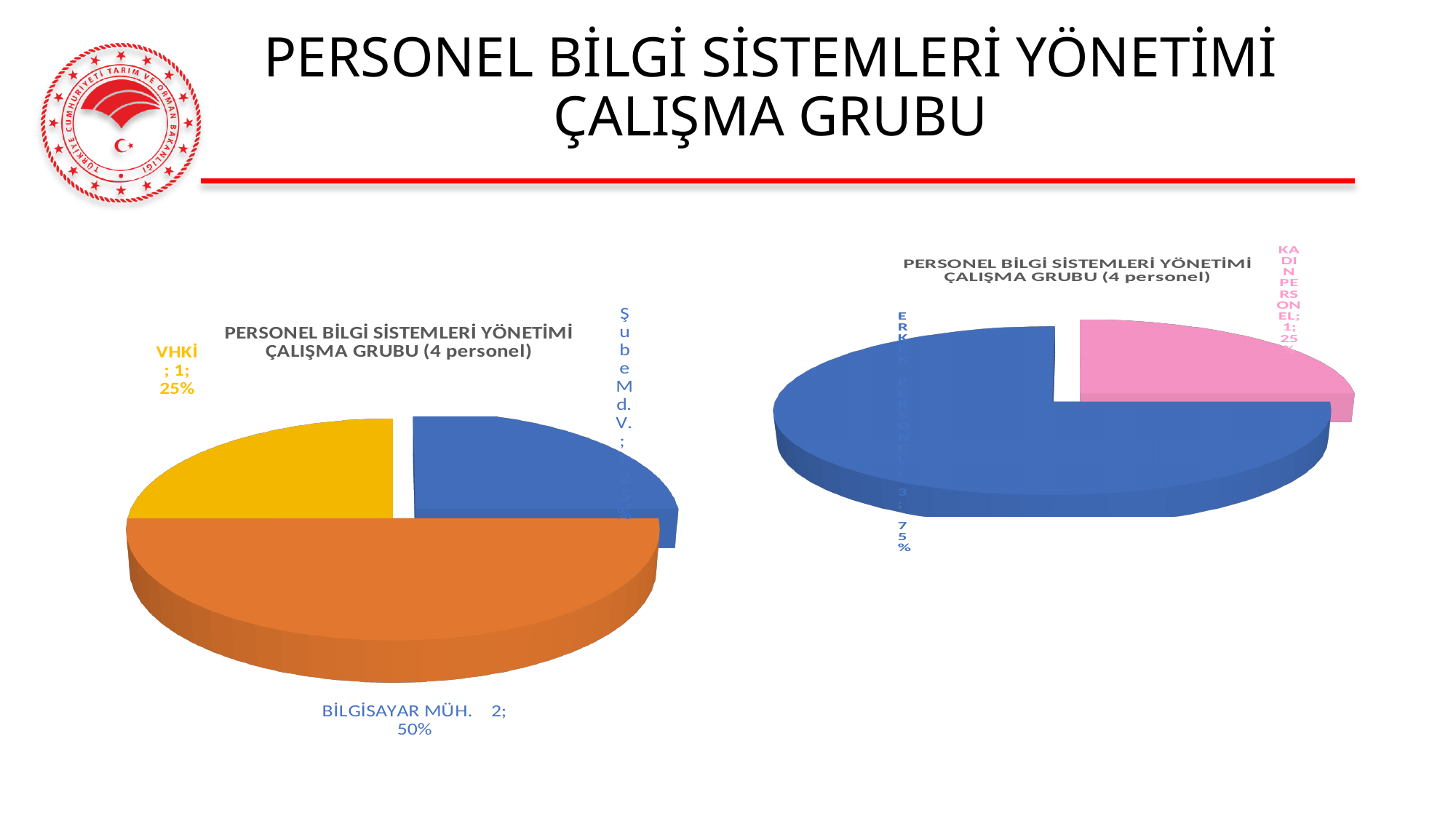
What type of chart is shown on the right side of the slide? Pie chart On the right pie chart, what share of the group is KADIN PERSONEL? 25% On the left pie chart, what share of the group is VHKİ? 25% On the left pie chart, what is the difference in personnel count between BİLGİSAYAR MÜH. and VHKİ? 1 On the left pie chart, how many personnel are BİLGİSAYAR MÜH.? 2 On the left pie chart, what share of the group is BİLGİSAYAR MÜH.? 50% On the right pie chart, how many personnel are ERKEK PERSONEL? 3 On the right pie chart, which category has the larger slice, ERKEK PERSONEL or KADIN PERSONEL? ERKEK PERSONEL On the left pie chart, how many categories are shown? 3 On the right pie chart, what colour is the KADIN PERSONEL slice? Pink On the right pie chart, how many categories are shown? 2 On the left pie chart, which category has the largest slice? BİLGİSAYAR MÜH.